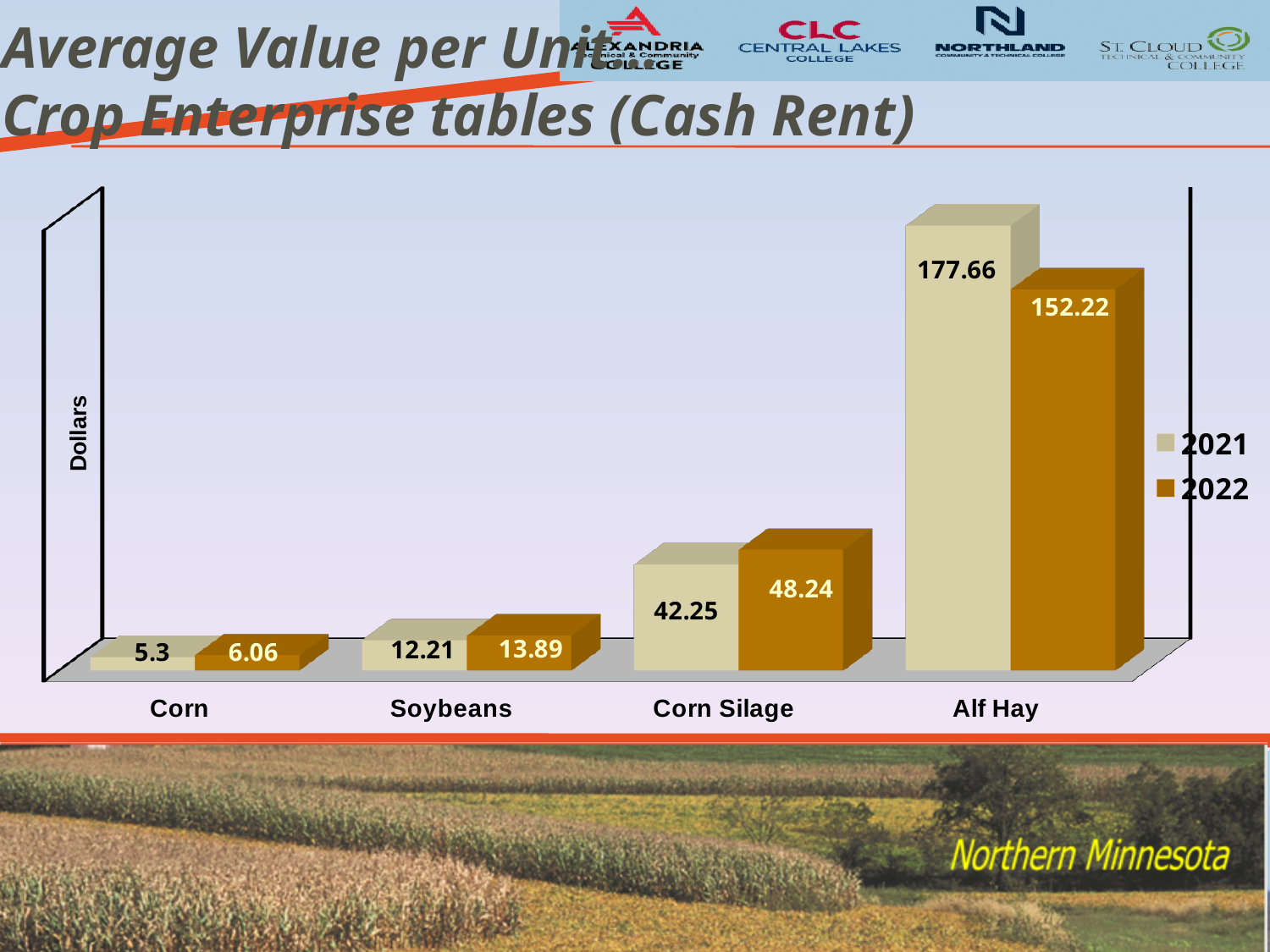
What is the 2022 value for Alf Hay? 152.22 Which is larger for Soybeans, the 2021 value or the 2022 value? 2022 What is the 2021 value for Soybeans? 12.21 How many crop categories are shown on the x axis? 4 What is the 2021 value for Corn Silage? 42.25 Which crop has the lowest 2022 value? Corn What kind of chart is shown on the slide? Bar chart What is the difference between the 2022 and 2021 values for Corn Silage? 5.99 What is the 2022 value for Corn? 6.06 What is the difference between the 2021 and 2022 values for Alf Hay? 25.44 How many series does the legend list? 2 Which crop has the highest 2021 value? Alf Hay